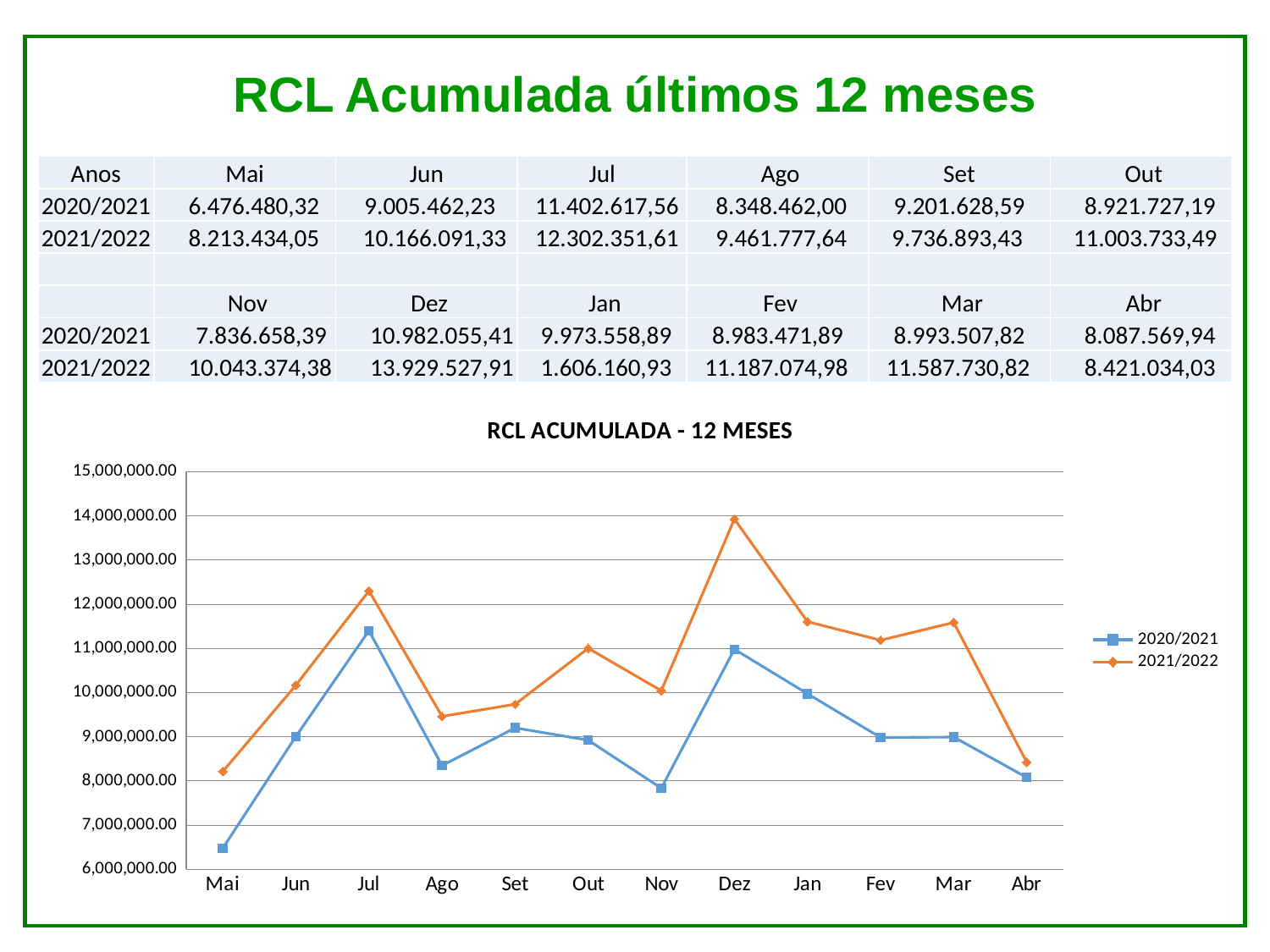
What is the difference between the 2021/2022 and 2020/2021 values in Jul? 899.734,05 What kind of chart is shown on the slide? line chart In which month does the 2021/2022 series reach its highest value? Dez In Jul, which series has the larger value, 2020/2021 or 2021/2022? 2021/2022 In which month does the 2020/2021 series have its lowest value? Mai What is the title of the chart? RCL ACUMULADA - 12 MESES What is the value for 2021/2022 in Dez? 13.929.527,91 What is the value for 2020/2021 in Mai? 6.476.480,32 How many series does the chart legend list? 2 In which month does the 2020/2021 series reach its highest value? Jul How many months are plotted along the x axis of the chart? 12 Is the value for 2021/2022 in Dez greater or less than 13,000,000.00? greater